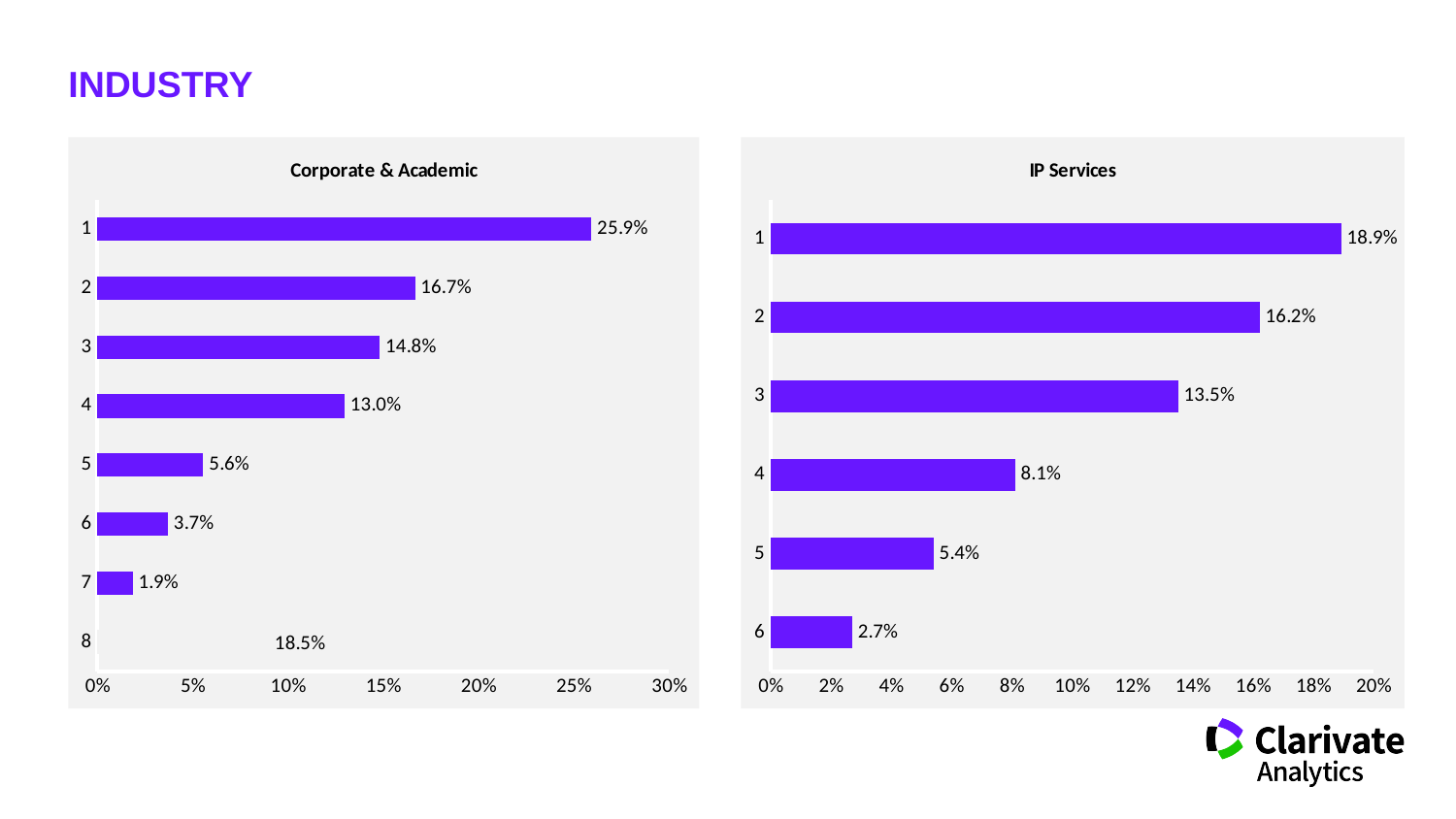
In the Corporate & Academic chart, what is the value for category 1? 25.9% In the IP Services chart, what is the difference between the values for category 1 and category 2? 2.7% In the IP Services chart, which category has the lowest value? 6 What is the title of the chart on the right side of the slide? IP Services What kind of chart is the Corporate & Academic chart? bar chart In the Corporate & Academic chart, what is the difference between the values for category 2 and category 3? 1.9% In the Corporate & Academic chart, what is the value for category 4? 13.0% How many categories are shown in the IP Services chart? 6 In the IP Services chart, what is the value for category 6? 2.7% In the Corporate & Academic chart, which category has the highest value? 1 In the IP Services chart, which is larger, the value for category 4 or category 5? category 4 In the IP Services chart, what is the value for category 3? 13.5%